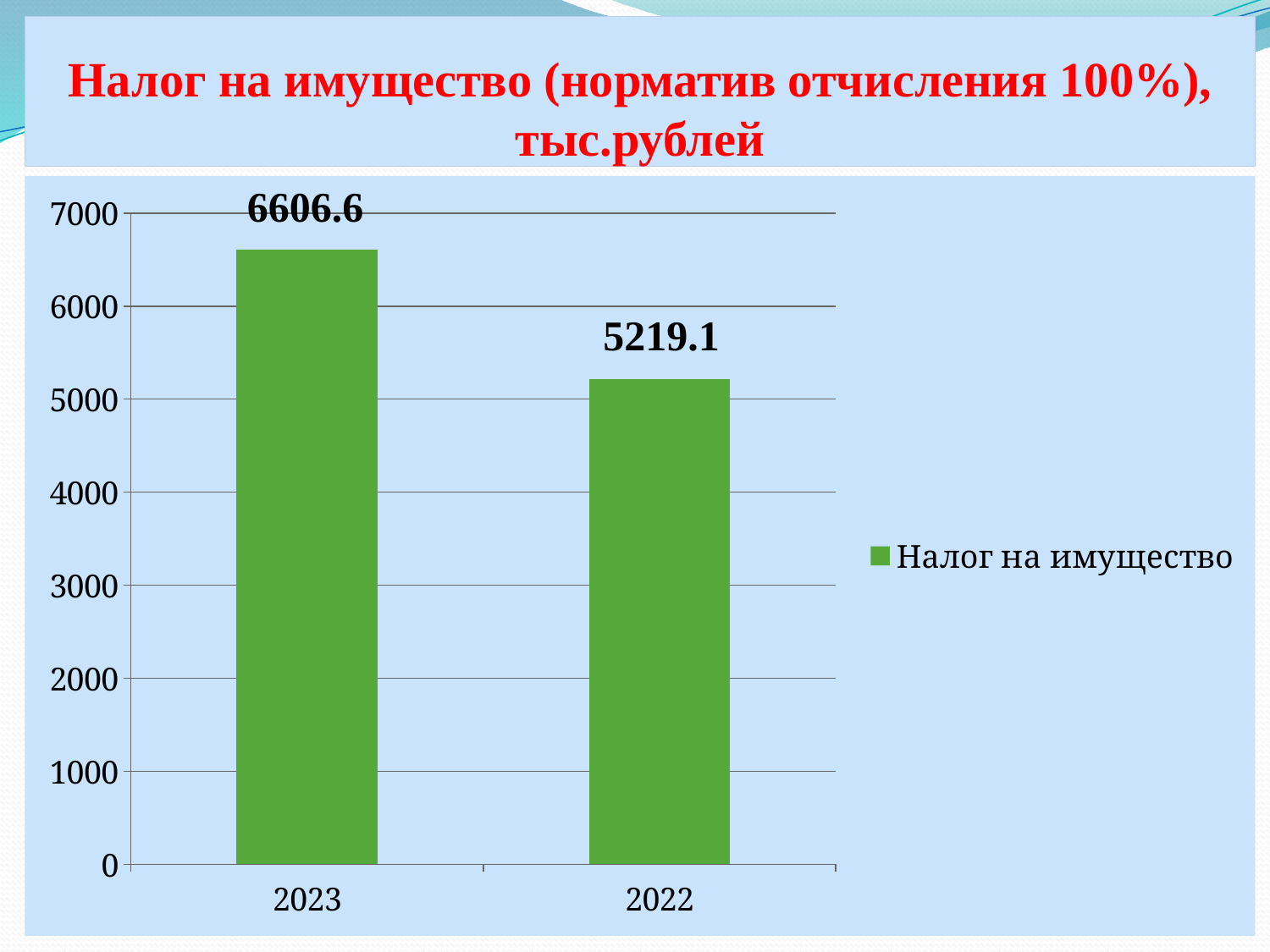
Is the value for 2022 greater or less than 5000? greater Which year has the lower value? 2022 Which year has the higher value? 2023 How many series does the legend list? 1 Is the value for 2023 greater or less than 7000? less What is the value for 2022? 5219.1 What is the value for 2023? 6606.6 What type of chart is shown? bar chart Is the value for 2023 larger or smaller than the value for 2022? larger What is the difference between the values for 2023 and 2022? 1387.5 What is the legend entry for the series? Налог на имущество How many bars are shown in the chart? 2